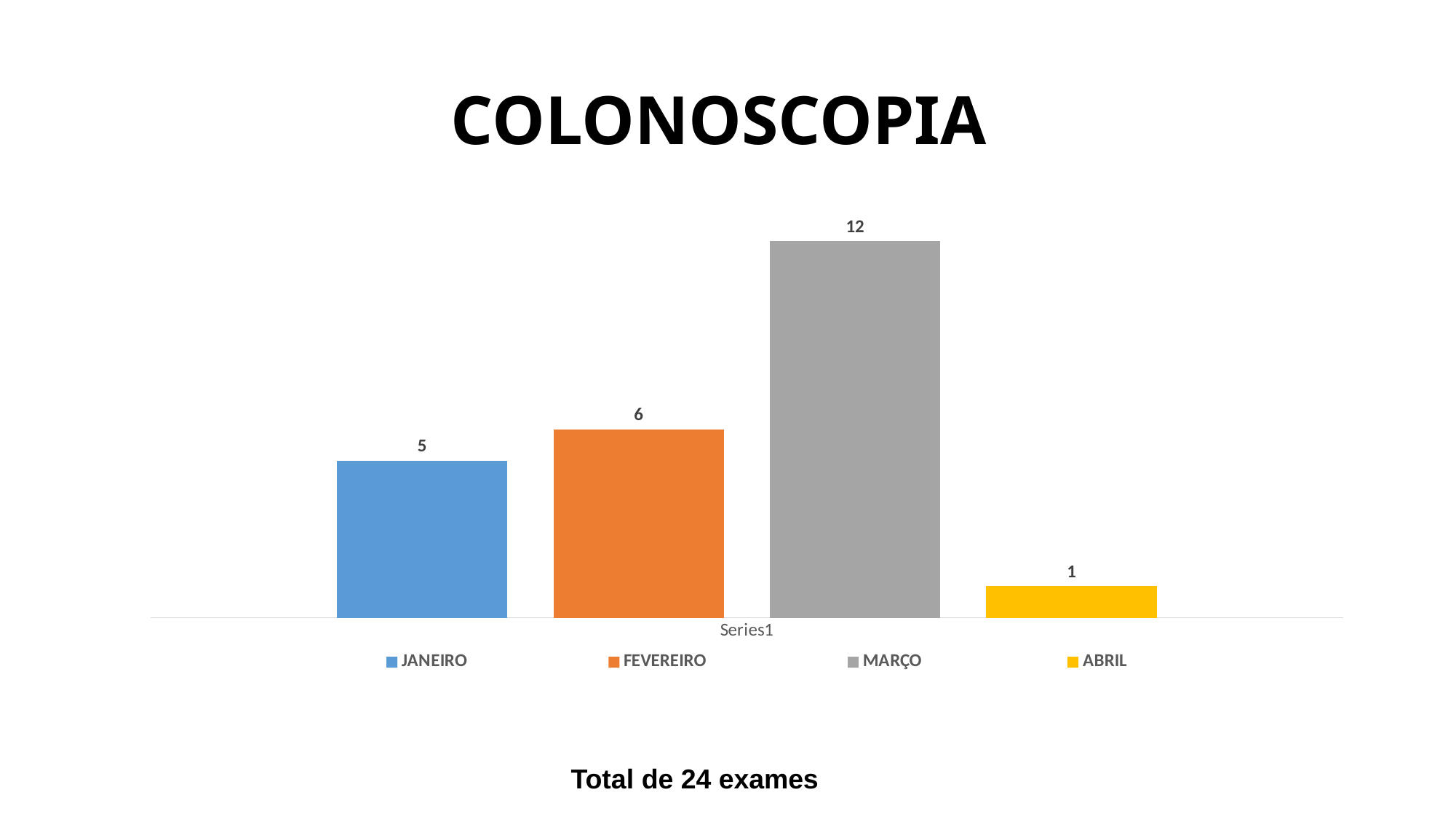
Which month has the highest value? MARÇO What is the value for JANEIRO? 5 What kind of chart is shown on the slide? bar chart What is the value for ABRIL? 1 Which month has the lowest value? ABRIL What is the difference between the values for MARÇO and FEVEREIRO? 6 What is the value for FEVEREIRO? 6 What is the value for MARÇO? 12 How many bars are shown in the chart? 4 Which is larger, the value for JANEIRO or the value for FEVEREIRO? FEVEREIRO What is the title of the chart? COLONOSCOPIA What is the difference between the values for JANEIRO and ABRIL? 4